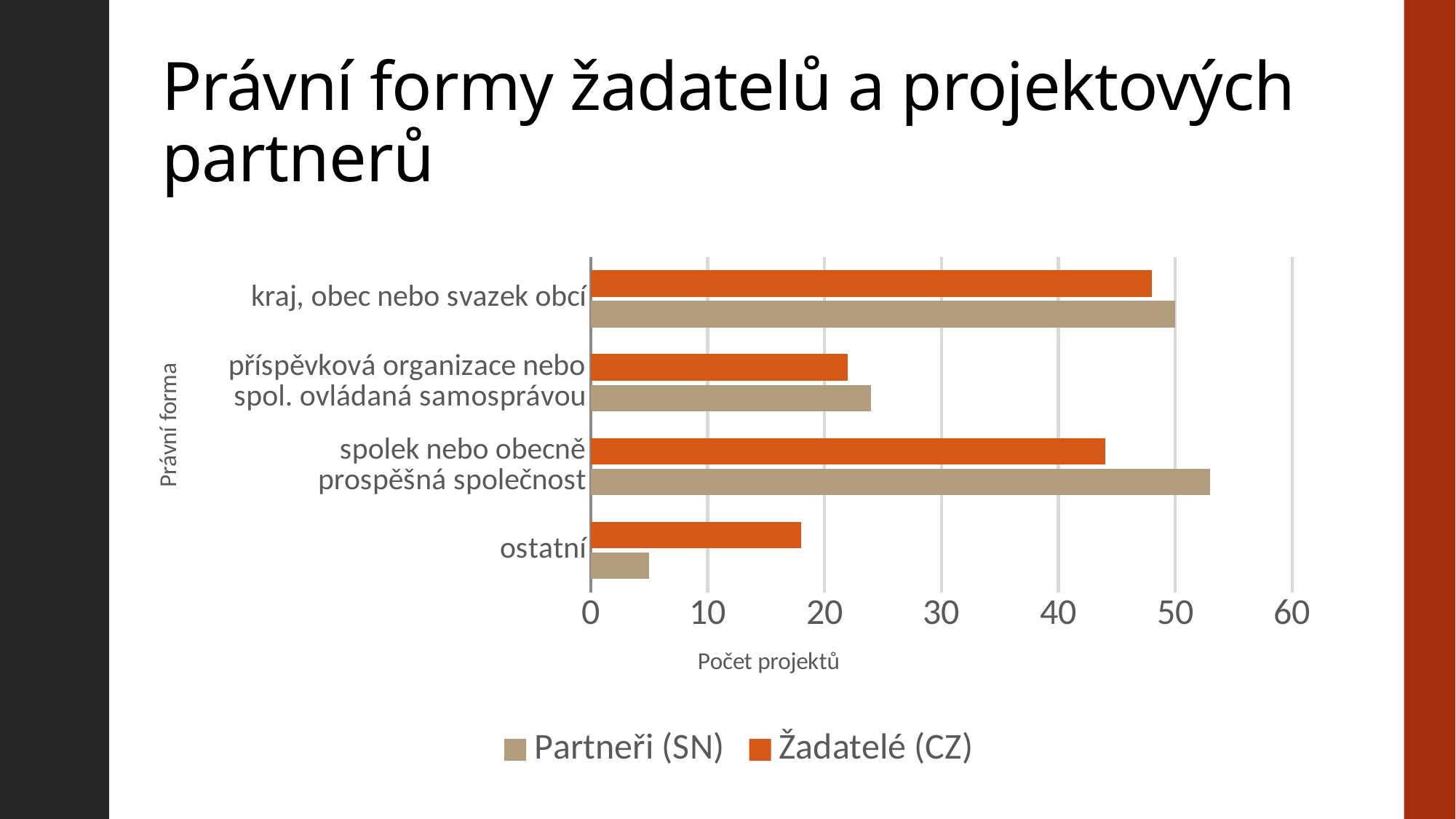
Which category has the lowest value for Žadatelé (CZ)? ostatní How many series does the legend list? 2 What kind of chart is shown on the slide? bar chart How many categories (legal forms) are shown on the chart? 4 What is the value for Partneři (SN) in the category 'kraj, obec nebo svazek obcí'? 50 Which category has the lowest value for Partneři (SN)? ostatní Is the value for Partneři (SN) in 'spolek nebo obecně prospěšná společnost' greater or less than 50? greater What is the title of the horizontal axis? Počet projektů In the category 'spolek nebo obecně prospěšná společnost', which series has the larger value, Partneři (SN) or Žadatelé (CZ)? Partneři (SN) Is the value for Partneři (SN) in 'ostatní' greater or less than 10? less Which category has the highest value for Žadatelé (CZ)? kraj, obec nebo svazek obcí In the category 'ostatní', which series has the larger value, Partneři (SN) or Žadatelé (CZ)? Žadatelé (CZ)